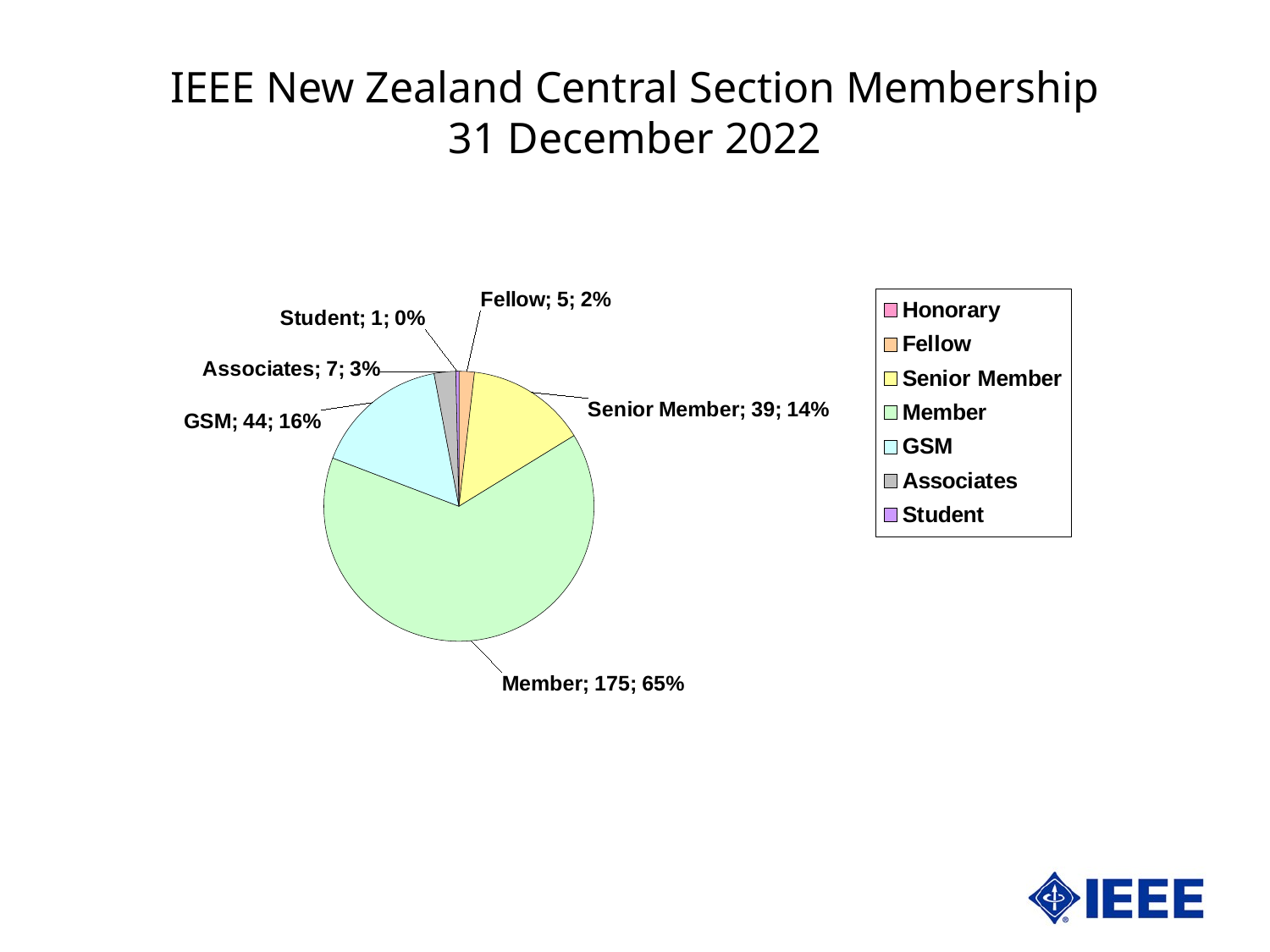
How many entries does the legend list? 7 What percentage of the membership is GSM? 16% What share of the pie does the Senior Member slice represent? 14% What colour is the Member slice in the pie chart? light green What is the percentage shown for the Fellow slice? 2% How many Senior Members are shown? 39 What is the difference between the GSM count and the Senior Member count? 5 How many members are in the Member category? 175 Which labelled category has the smallest count? Student What kind of chart is shown on the slide? pie chart Which is larger, the Fellow count or the Associates count? Associates Which category has the largest slice of the pie? Member